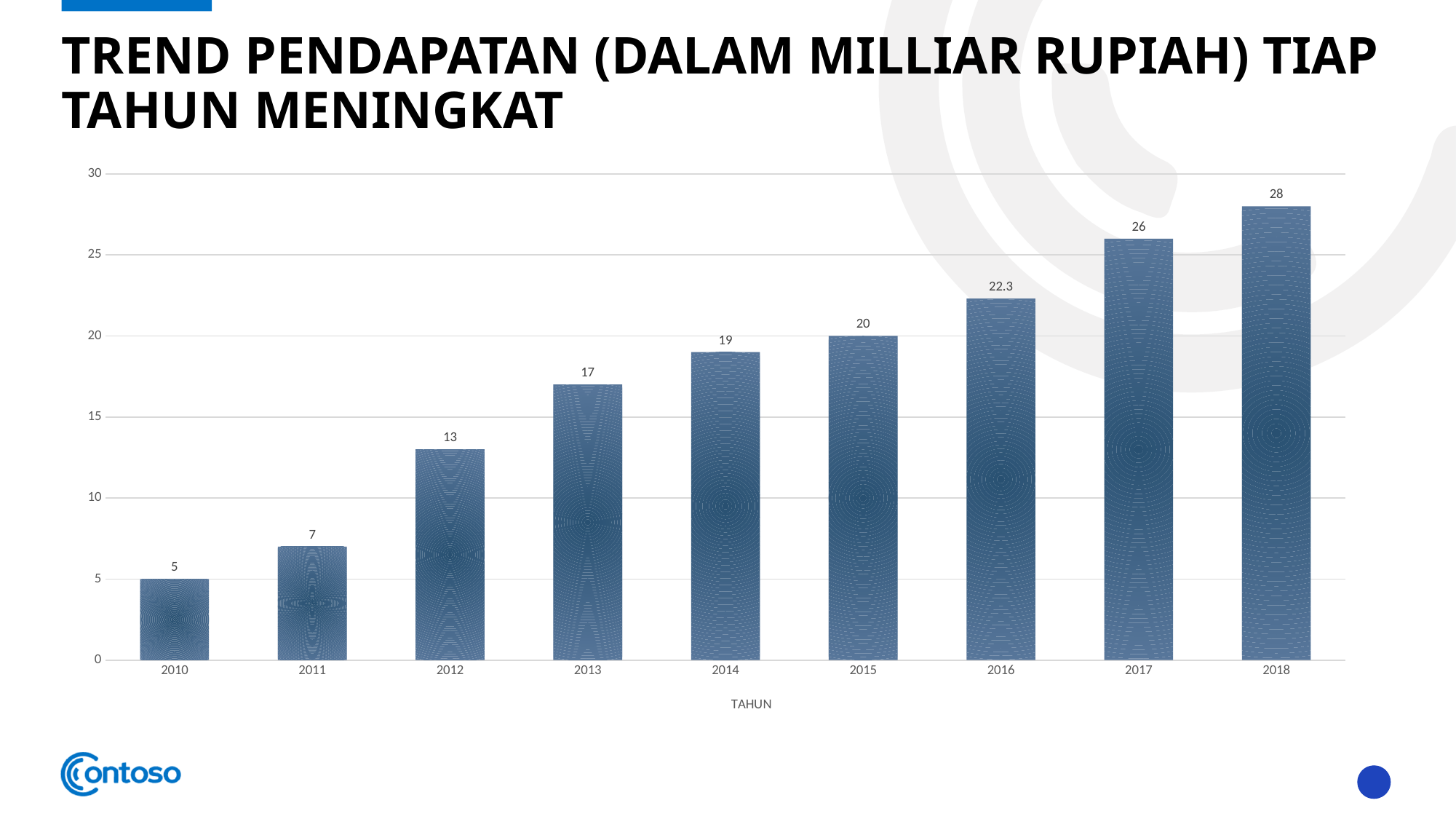
Do the values rise or fall from 2010 to 2018? rise What is the value for 2016? 22.3 What kind of chart is shown on the slide? bar chart What is the value for 2010? 5 Which year has the highest value? 2018 Which is larger, the value for 2013 or the value for 2015? 2015 What is the value for 2014? 19 What is the label of the x axis? TAHUN How many years are shown on the x axis? 9 What is the difference between the values for 2018 and 2017? 2 What is the difference between the values for 2012 and 2011? 6 Which year has the lowest value? 2010